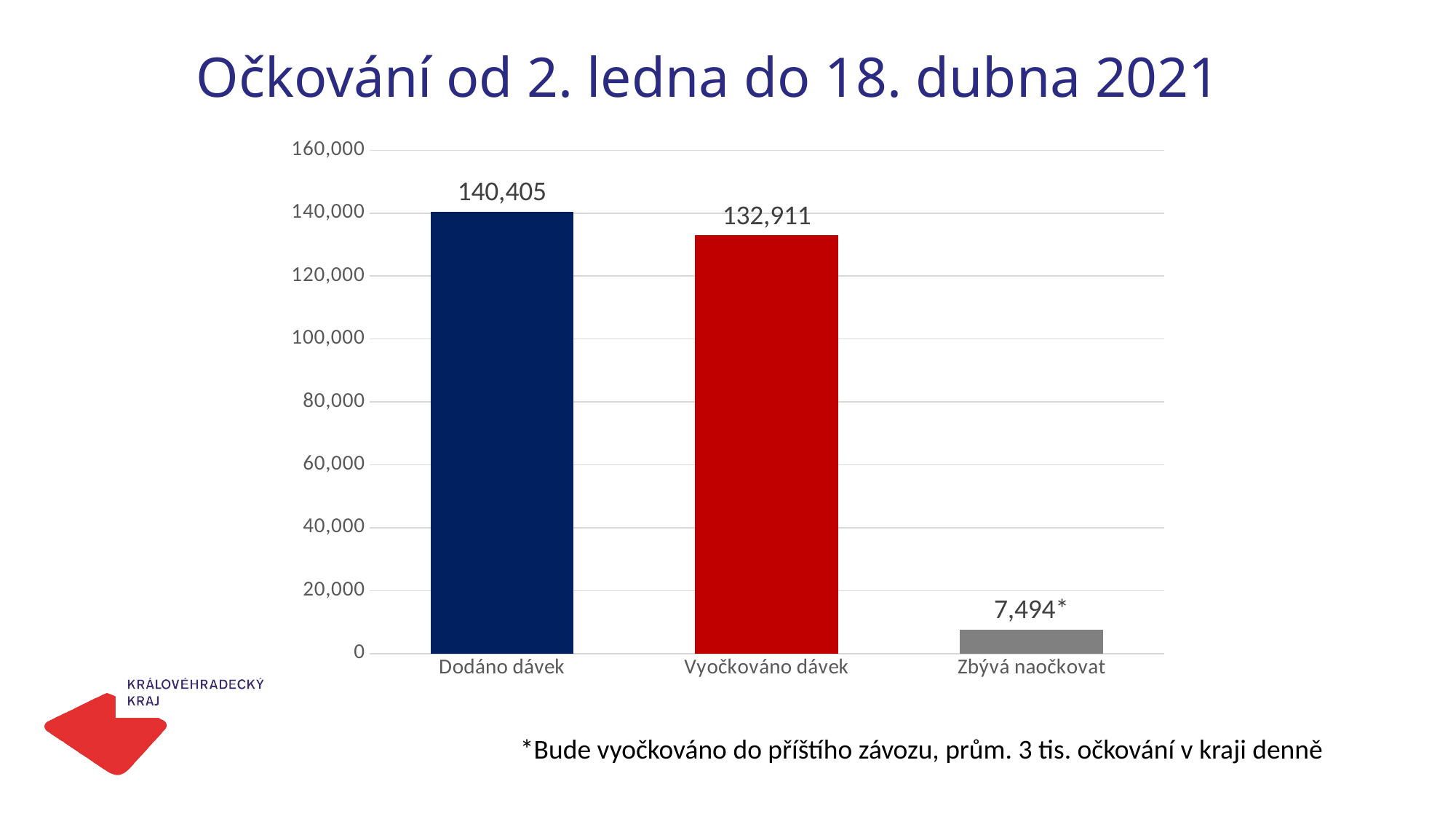
Is the value for Vyočkováno dávek greater or less than 140,000? less What kind of chart is shown on the slide? bar chart Is the value for Zbývá naočkovat greater or less than 20,000? less What is the value for Dodáno dávek? 140,405 Which is larger, Vyočkováno dávek or Zbývá naočkovat? Vyočkováno dávek Which category has the highest value? Dodáno dávek What is the value for Vyočkováno dávek? 132,911 Which category has the lowest value? Zbývá naočkovat What is the difference between Dodáno dávek and Vyočkováno dávek? 7,494 How many categories are shown in the chart? 3 What is the title of the slide? Očkování od 2. ledna do 18. dubna 2021 What is the value for Zbývá naočkovat? 7,494